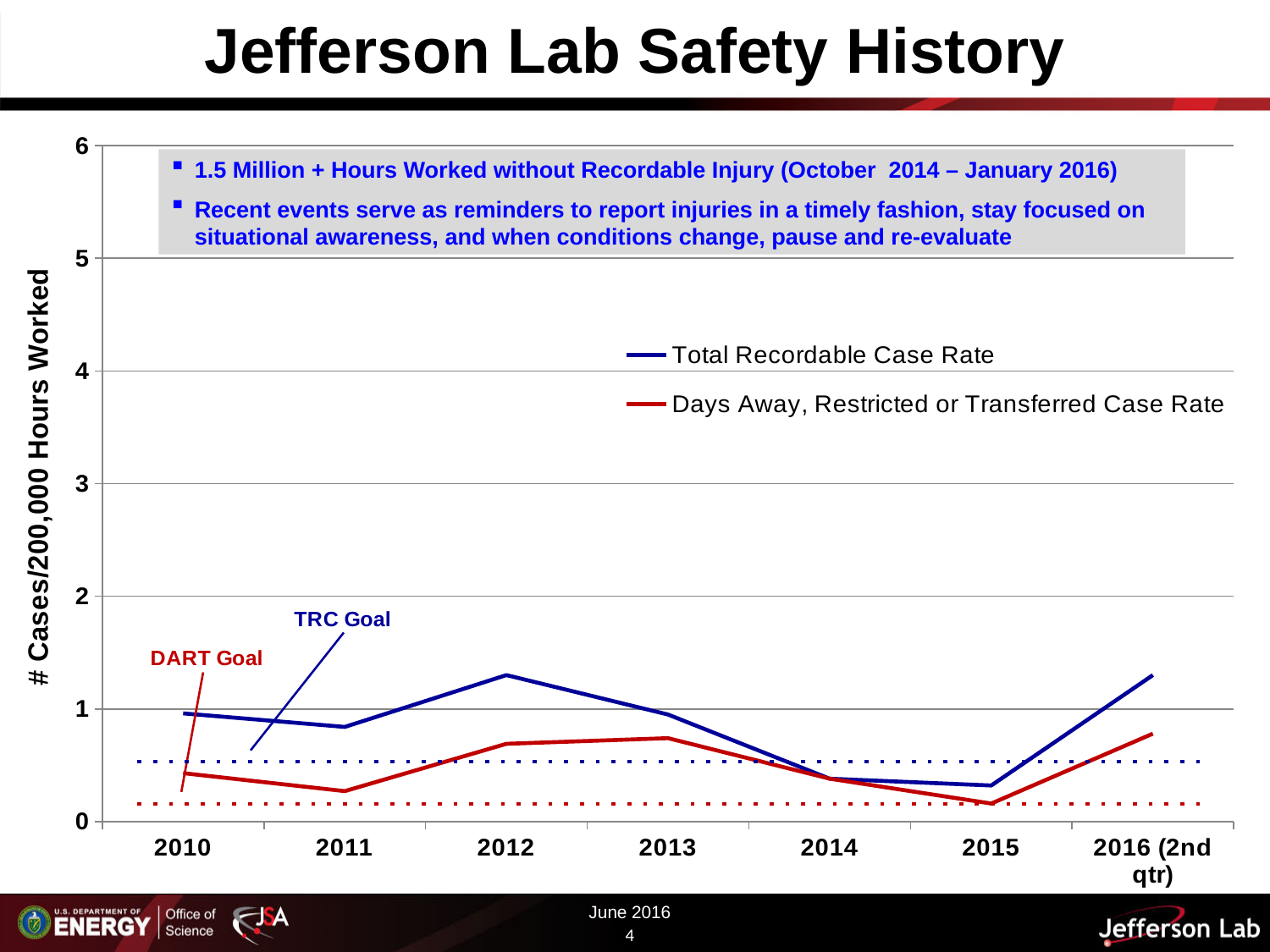
What colour is the Total Recordable Case Rate line? Blue Is the Total Recordable Case Rate for 2015 greater or less than 1? less Is the Total Recordable Case Rate for 2012 greater or less than 1? greater How many series does the chart legend list? 2 Is the Days Away, Restricted or Transferred Case Rate for 2013 greater or less than 1? less Which is larger, the Total Recordable Case Rate in 2012 or in 2015? 2012 How many years (points) are shown along the x axis of the chart? 7 What kind of chart is shown on the slide? Line chart In which year is the Days Away, Restricted or Transferred Case Rate lowest? 2015 In 2010, which series has the higher value, Total Recordable Case Rate or Days Away, Restricted or Transferred Case Rate? Total Recordable Case Rate Does the Total Recordable Case Rate rise or fall from 2013 to 2015? Fall What is the label of the y axis? # Cases/200,000 Hours Worked